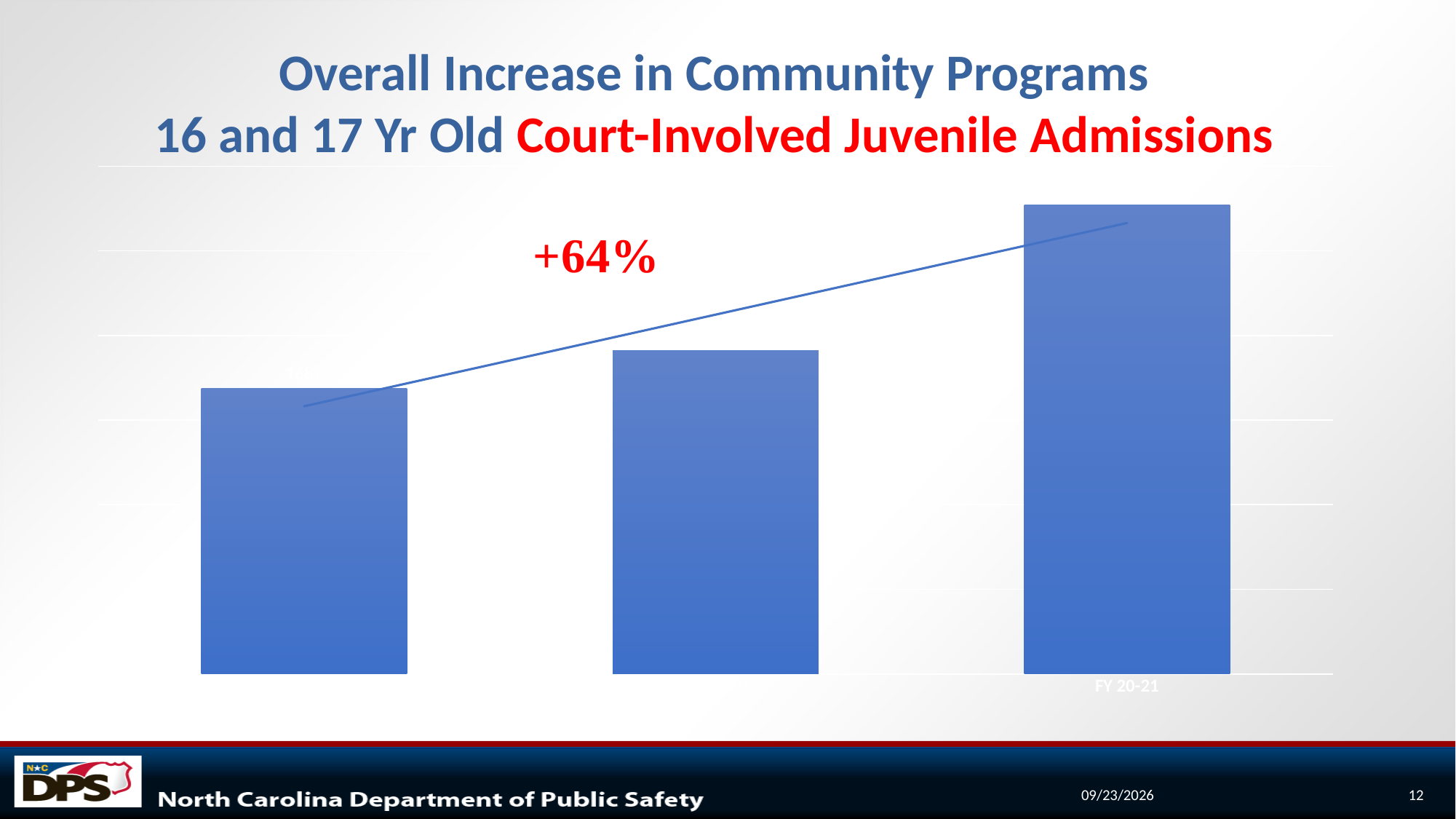
What is the title of the slide containing the chart? Overall Increase in Community Programs 16 and 17 Yr Old Court-Involved Juvenile Admissions What percentage increase is annotated on the chart? +64% Which bar is the shortest: the leftmost, the middle, or the rightmost? leftmost Is the bar for FY 20-21 taller or shorter than the middle bar? taller What kind of chart is shown on the slide? bar chart Which fiscal year has the tallest bar in the chart? FY 20-21 Do the bar values rise or fall from left to right across the chart? rise How many bars are plotted in the chart? 3